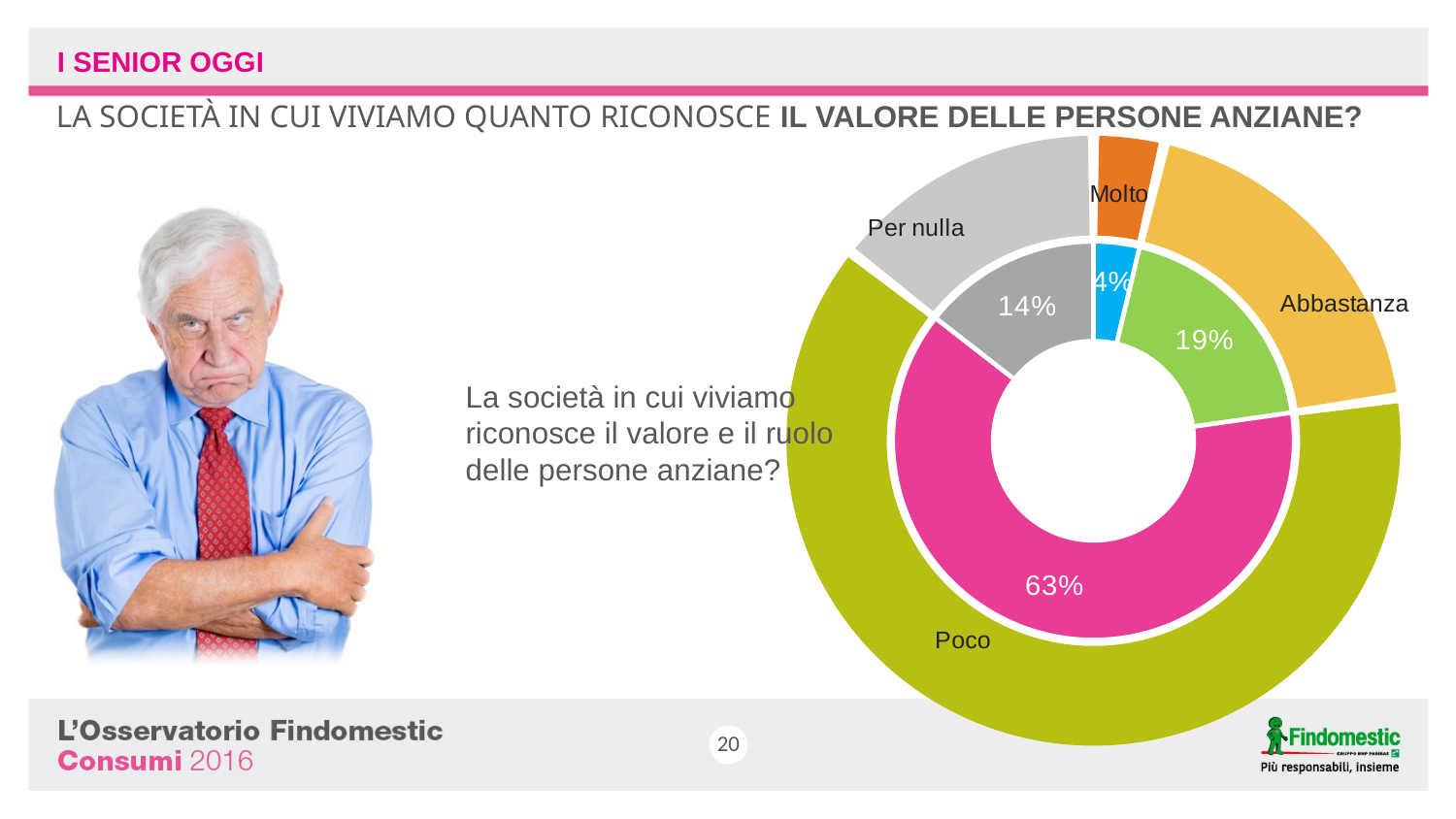
What percentage of respondents answered "Abbastanza"? 19% Which is larger, the share for "Abbastanza" or the share for "Per nulla"? Abbastanza What kind of chart is shown on the slide? Doughnut chart What percentage of respondents answered "Per nulla"? 14% What is the combined share of "Molto" and "Abbastanza"? 23% What is the difference in percentage points between "Poco" and "Abbastanza"? 44 How many response categories does the chart show? 4 Which response category has the largest share? Poco What percentage of respondents answered "Poco"? 63% What percentage of respondents answered "Molto"? 4% What is the difference in percentage points between "Per nulla" and "Molto"? 10 Which response category has the smallest share? Molto